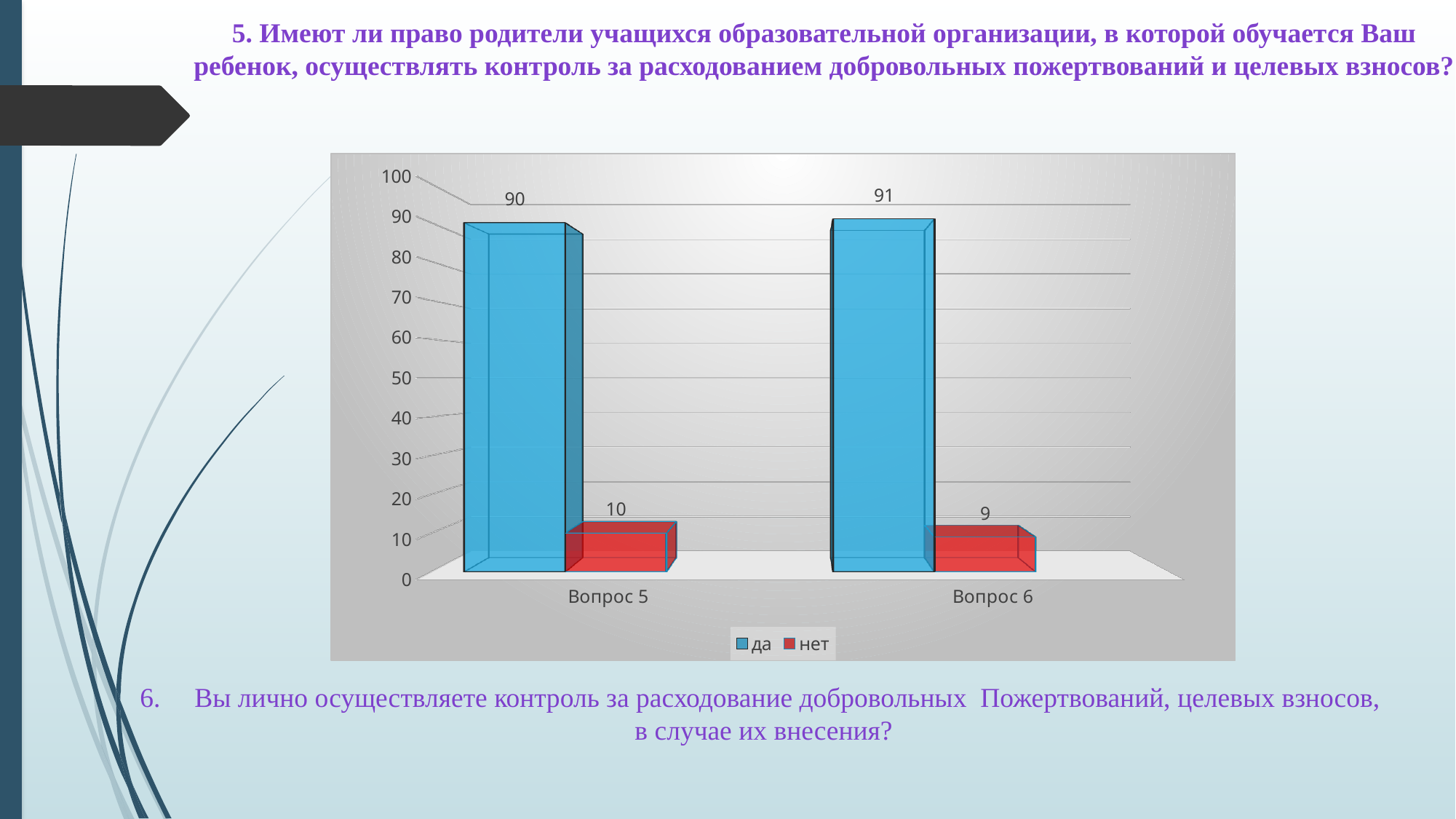
Which is larger for Вопрос 6: "да" or "нет"? да How many categories are shown on the x axis? 2 What is the value for "да" for Вопрос 6? 91 What is the value for "нет" for Вопрос 6? 9 What is the difference between the "да" and "нет" values for Вопрос 5? 80 What kind of chart is shown on the slide? bar chart What is the value for "да" for Вопрос 5? 90 How many series does the legend list? 2 Which category has the lowest value for "нет"? Вопрос 6 What is the value for "нет" for Вопрос 5? 10 What colour are the bars for the "нет" series? red Which category has the highest value for "да"? Вопрос 6